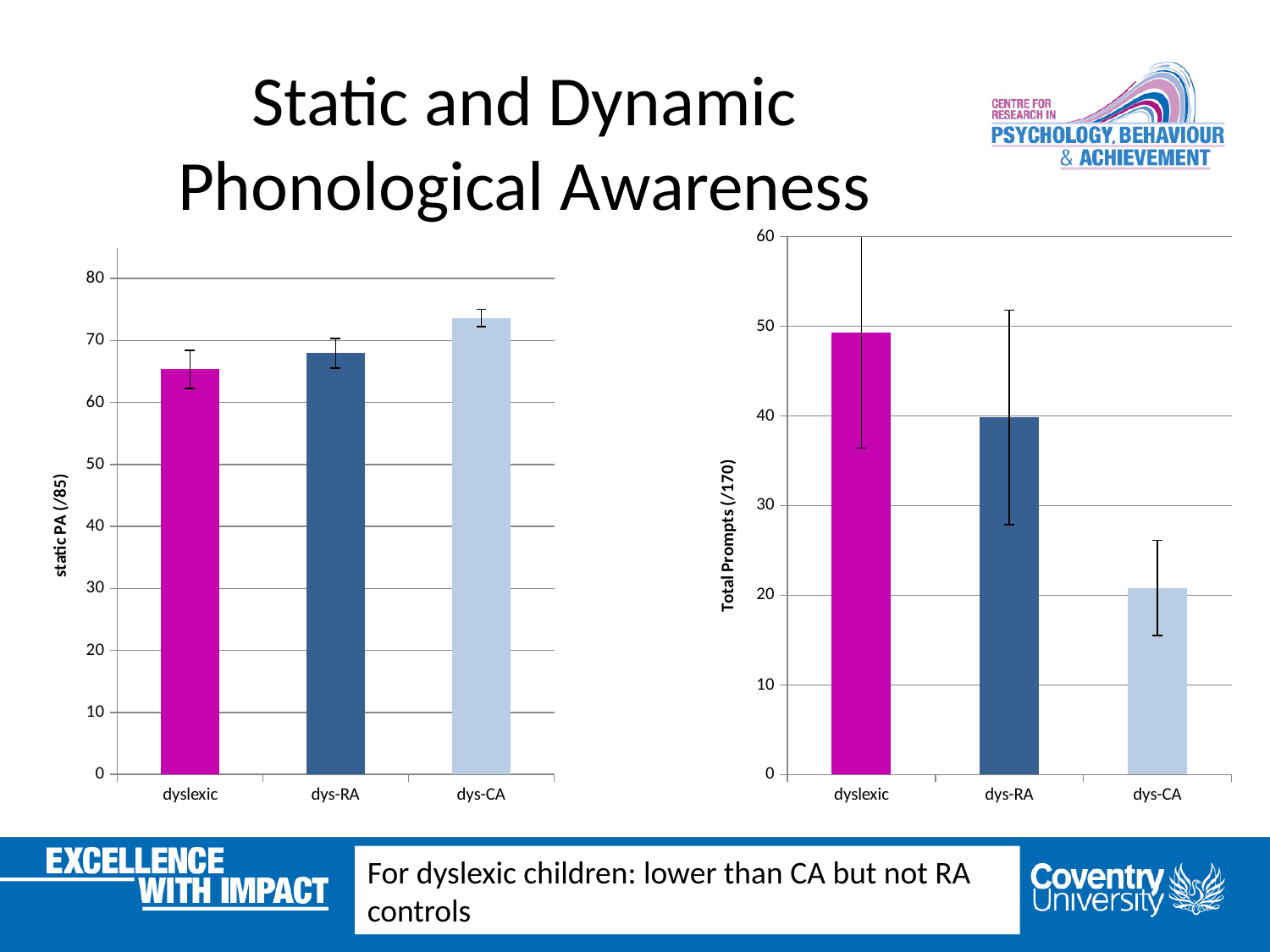
In the left chart (static PA), which category has the highest value? dys-CA In the right chart (Total Prompts), is the value for dyslexic greater or less than 40? greater In the left chart (static PA), which is larger: the value for dys-CA or the value for dyslexic? dys-CA In the right chart (Total Prompts), which category has the lowest value? dys-CA What is the y-axis label of the right chart? Total Prompts (/170) In the right chart (Total Prompts), do the values rise or fall from dyslexic to dys-CA along the x axis? fall In the left chart (static PA), is the value for dys-CA greater or less than 70? greater In the left chart (static PA), is the value for dyslexic greater or less than 60? greater In the right chart (Total Prompts), which category has the highest value? dyslexic What kind of chart is the left chart (static PA)? bar chart How many categories are shown on the x axis of the right chart (Total Prompts)? 3